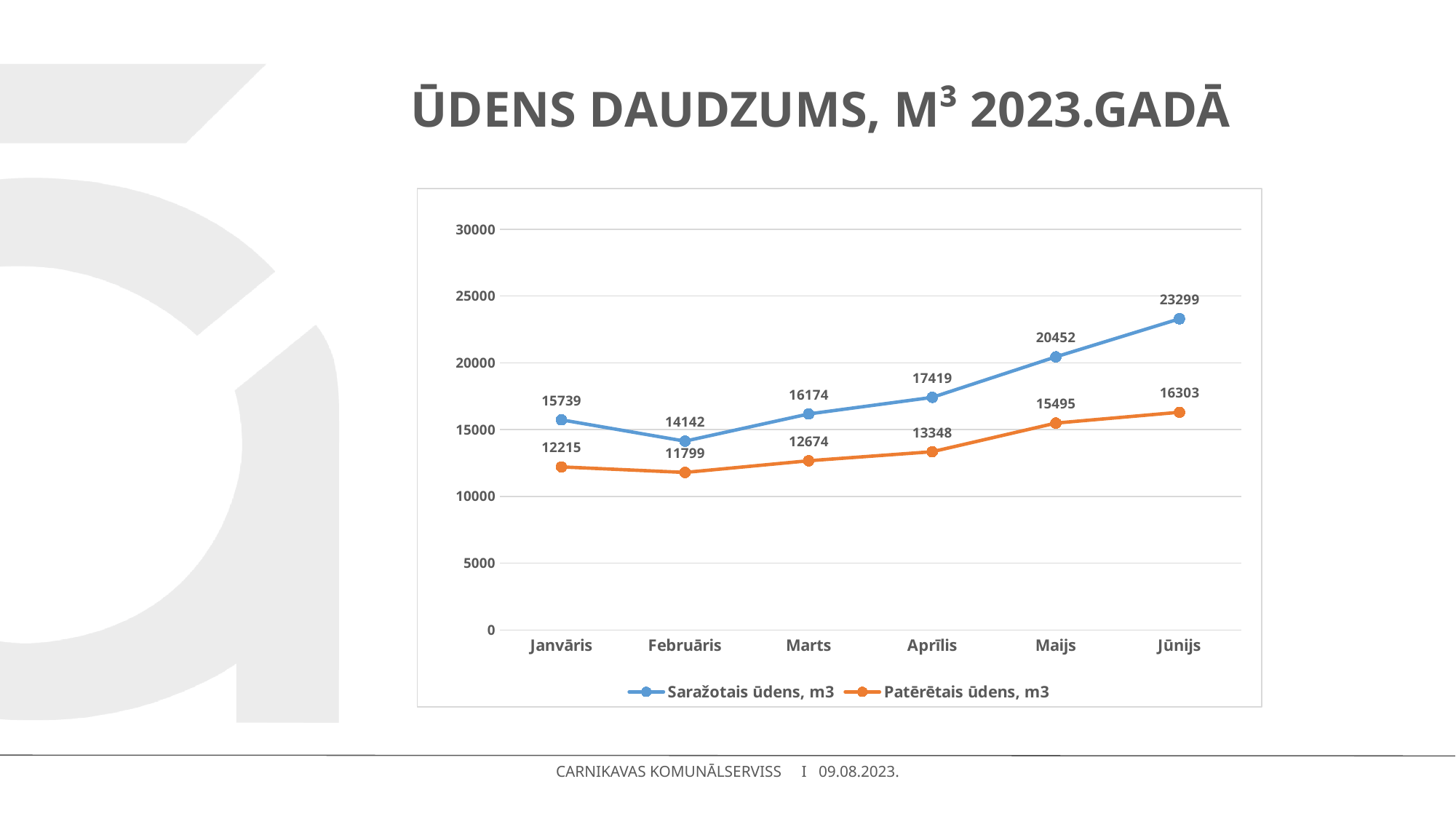
What is the title of the chart? ŪDENS DAUDZUMS, M³ 2023.GADĀ Is the value for Saražotais ūdens, m3 in Maijs greater or less than 20000? greater How many series does the legend list? 2 What is the value of Saražotais ūdens, m3 for Jūnijs? 23299 What is the value of Patērētais ūdens, m3 for Aprīlis? 13348 Which is larger in Janvāris: Saražotais ūdens, m3 or Patērētais ūdens, m3? Saražotais ūdens, m3 What kind of chart is shown on the slide? Line chart Which month has the highest value for Saražotais ūdens, m3? Jūnijs What is the difference between Saražotais ūdens, m3 and Patērētais ūdens, m3 in Maijs? 4957 Which month has the lowest value for Patērētais ūdens, m3? Februāris What is the value of Saražotais ūdens, m3 for Marts? 16174 How many months are shown on the x axis? 6